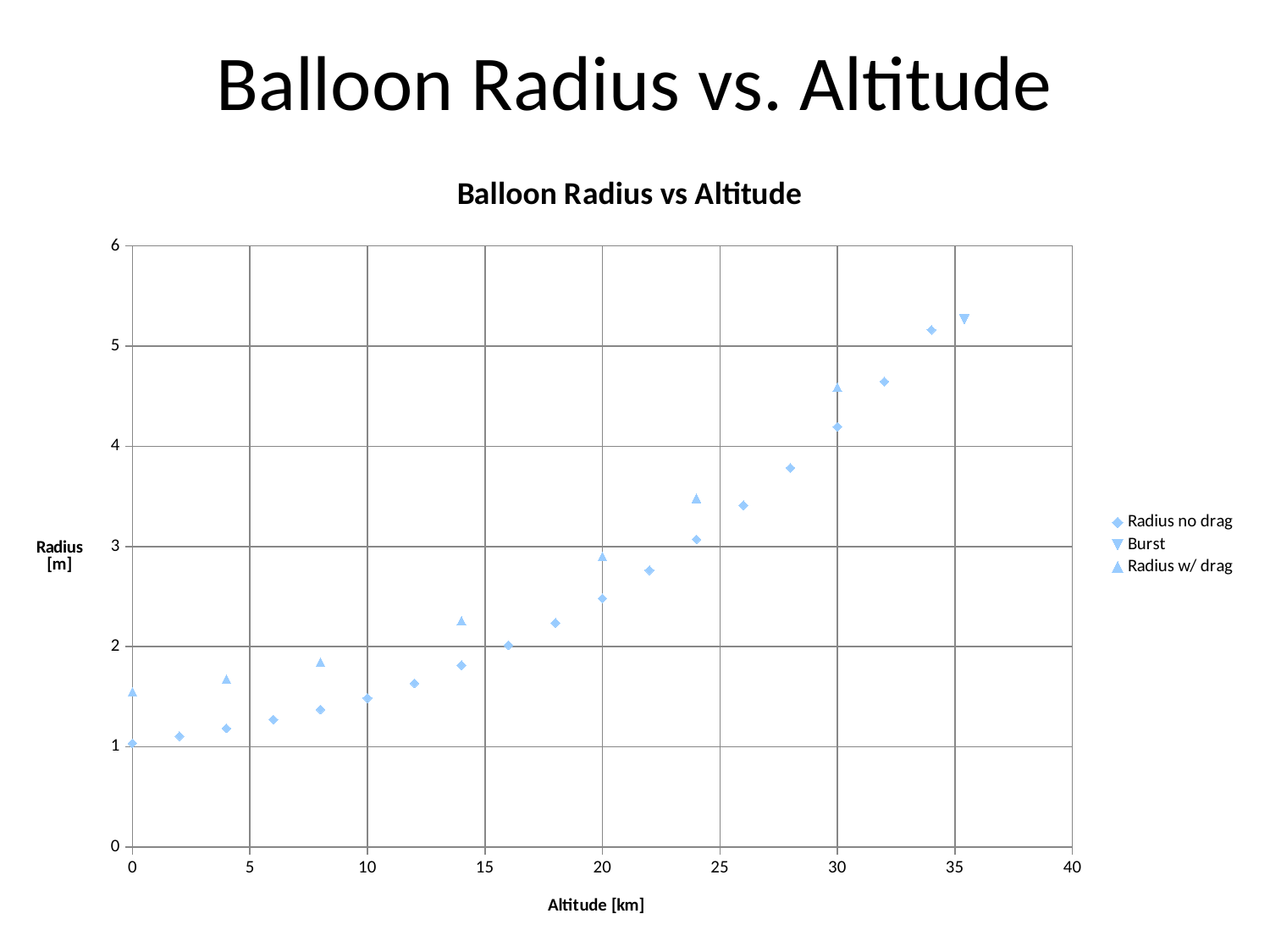
What is the label of the x axis? Altitude [km] How many points are plotted for the Radius w/ drag series? 7 Is the Radius no drag value at an altitude of 10 km greater or less than 2? less Do the Radius no drag values rise or fall as altitude increases? Rise Is the Radius no drag value at an altitude of 30 km greater or less than 4? greater What kind of chart is shown on the slide? Scatter chart At an altitude of 0 km, which series has the larger radius, Radius no drag or Radius w/ drag? Radius w/ drag How many series does the legend list? 3 At an altitude of 20 km, which series has the larger radius, Radius no drag or Radius w/ drag? Radius w/ drag What is the title of the chart? Balloon Radius vs Altitude Is the Burst point's radius greater or less than 5? greater